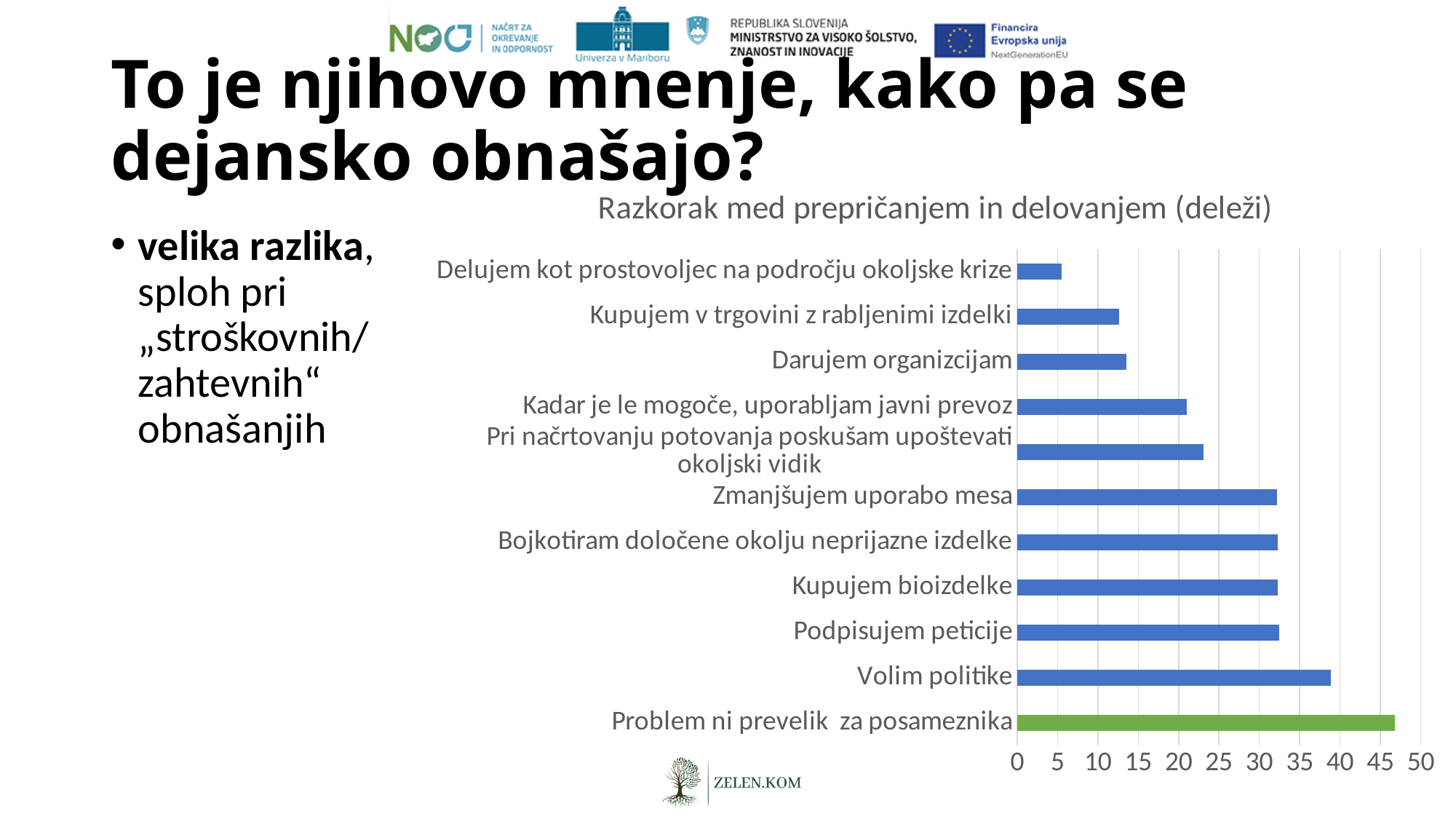
Which has a larger value: "Volim politike" or "Podpisujem peticije"? Volim politike Is the value for "Volim politike" greater or less than 35? greater What colour is the bar for "Problem ni prevelik za posameznika"? green Is the value for "Delujem kot prostovoljec na področju okoljske krize" greater or less than 10? less Is the value for "Kadar je le mogoče, uporabljam javni prevoz" greater or less than 25? less What kind of chart is shown on the slide? bar chart What is the title of the chart? Razkorak med prepričanjem in delovanjem (deleži) Which has a larger value: "Darujem organizcijam" or "Zmanjšujem uporabo mesa"? Zmanjšujem uporabo mesa How many categories are plotted in the chart? 11 Which category has the highest value in the chart? Problem ni prevelik za posameznika Which category has the lowest value in the chart? Delujem kot prostovoljec na področju okoljske krize